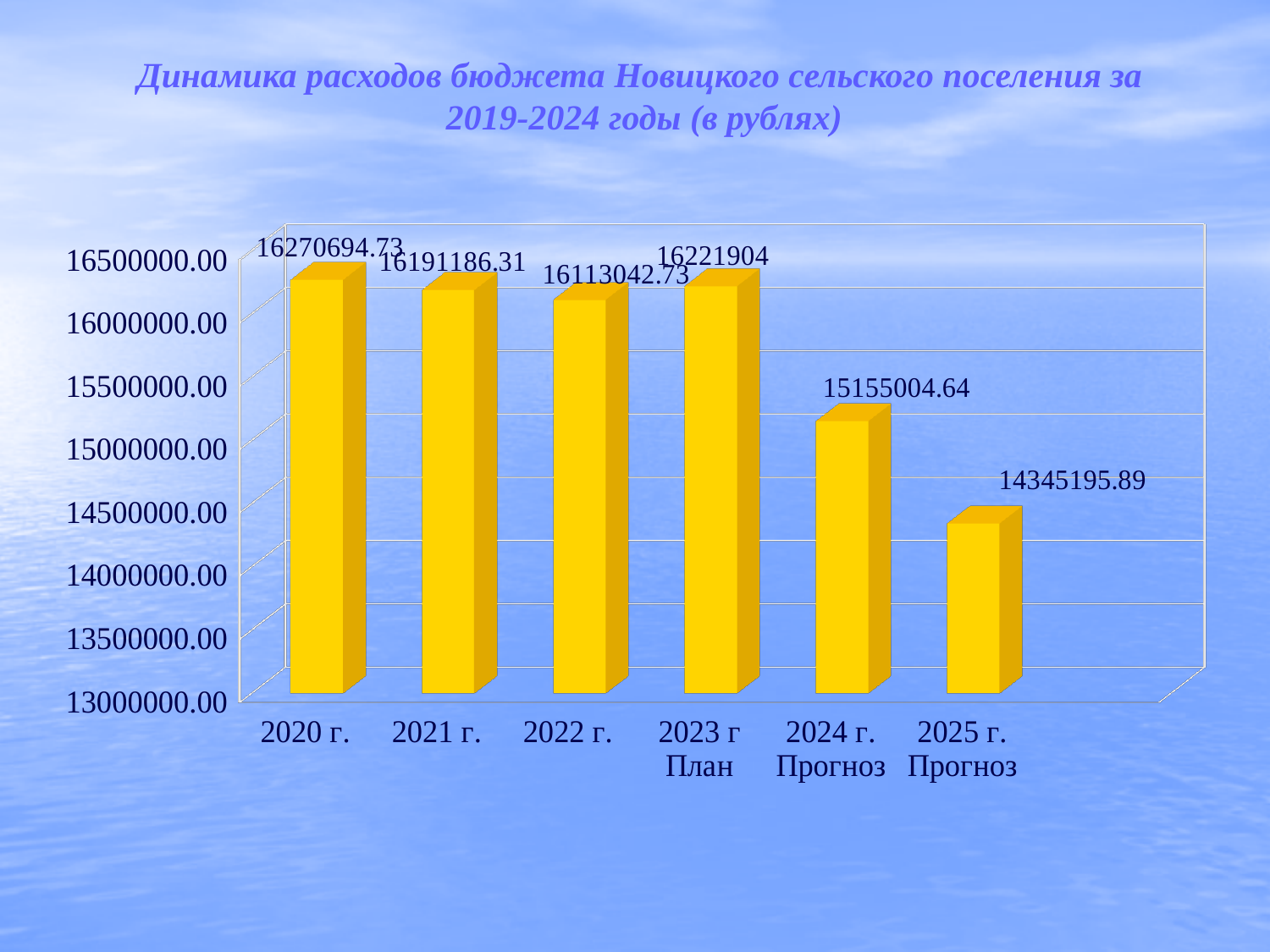
What is the value shown for 2025 г. Прогноз? 14345195.89 How many categories are shown on the x axis? 6 What is the value shown for 2020 г.? 16270694.73 What kind of chart is shown on the slide? bar chart Which is larger, the value for 2022 г. or the value for 2023 г План? 2023 г План What is the difference between the values for 2020 г. and 2021 г.? 79508.42 What is the difference between the values for 2024 г. Прогноз and 2025 г. Прогноз? 809808.75 What is the value shown for 2023 г План? 16221904 Which category has the highest value? 2020 г. Is the value for 2024 г. Прогноз greater or less than 15000000.00? greater Do the values rise or fall from 2023 г План to 2025 г. Прогноз? fall Which category has the lowest value? 2025 г. Прогноз